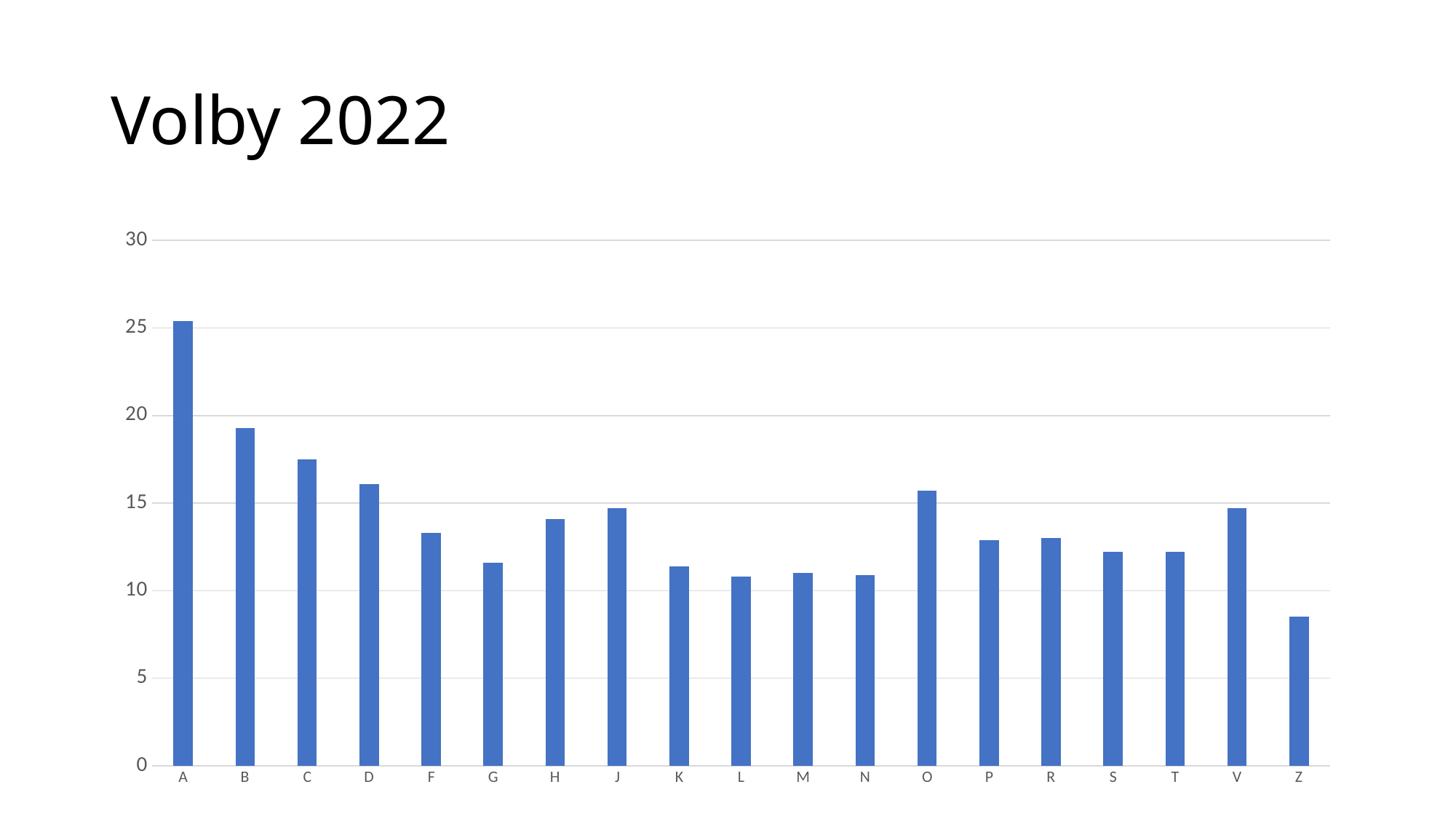
What kind of chart is shown on the slide? bar chart Is the value for Z greater or less than 10? less Is the value for G greater or less than 10? greater Is the value for B greater or less than 20? less How many categories are shown on the x axis of the chart? 19 What is the title shown above the chart on the slide? Volby 2022 Which is larger, the value for O or the value for P? O Which category has the highest bar in the chart? A Which category has the lowest bar in the chart? Z Which is larger, the value for B or the value for C? B